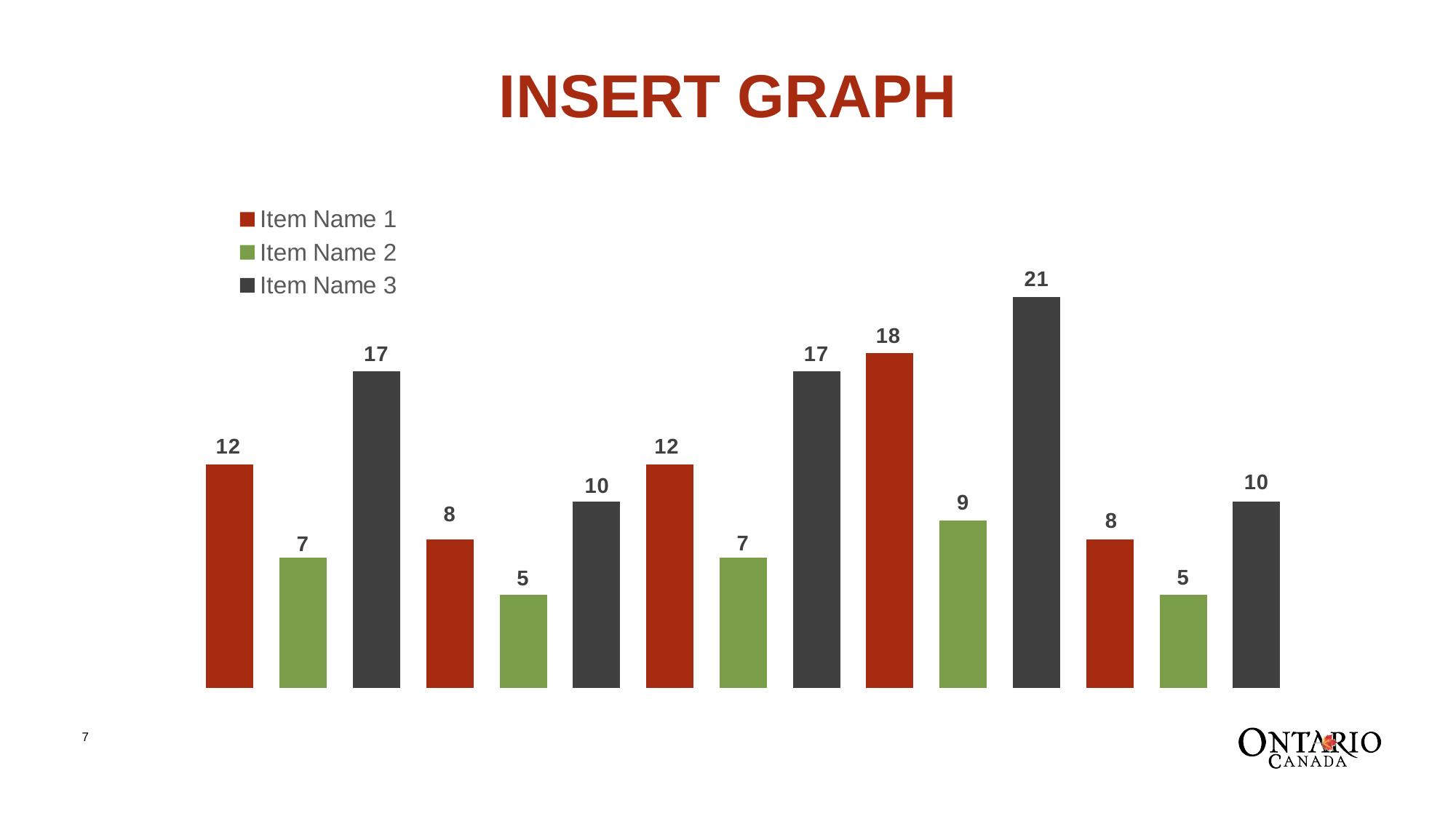
What colour are the bars for Item Name 2? green What is the value of Item Name 1 in the first group of bars? 12 What kind of chart is shown on the slide? bar chart What is the value of Item Name 3 in the fourth group of bars? 21 What is the difference between Item Name 3 and Item Name 1 in the fourth group of bars? 3 What is the title of the slide? INSERT GRAPH How many groups of bars are plotted in the chart? 5 In the second group of bars, which is larger: Item Name 1 or Item Name 3? Item Name 3 Which series has the highest value in the chart? Item Name 3 What is the value of Item Name 2 in the second group of bars? 5 How many series does the legend list? 3 What is the lowest value shown for Item Name 2? 5